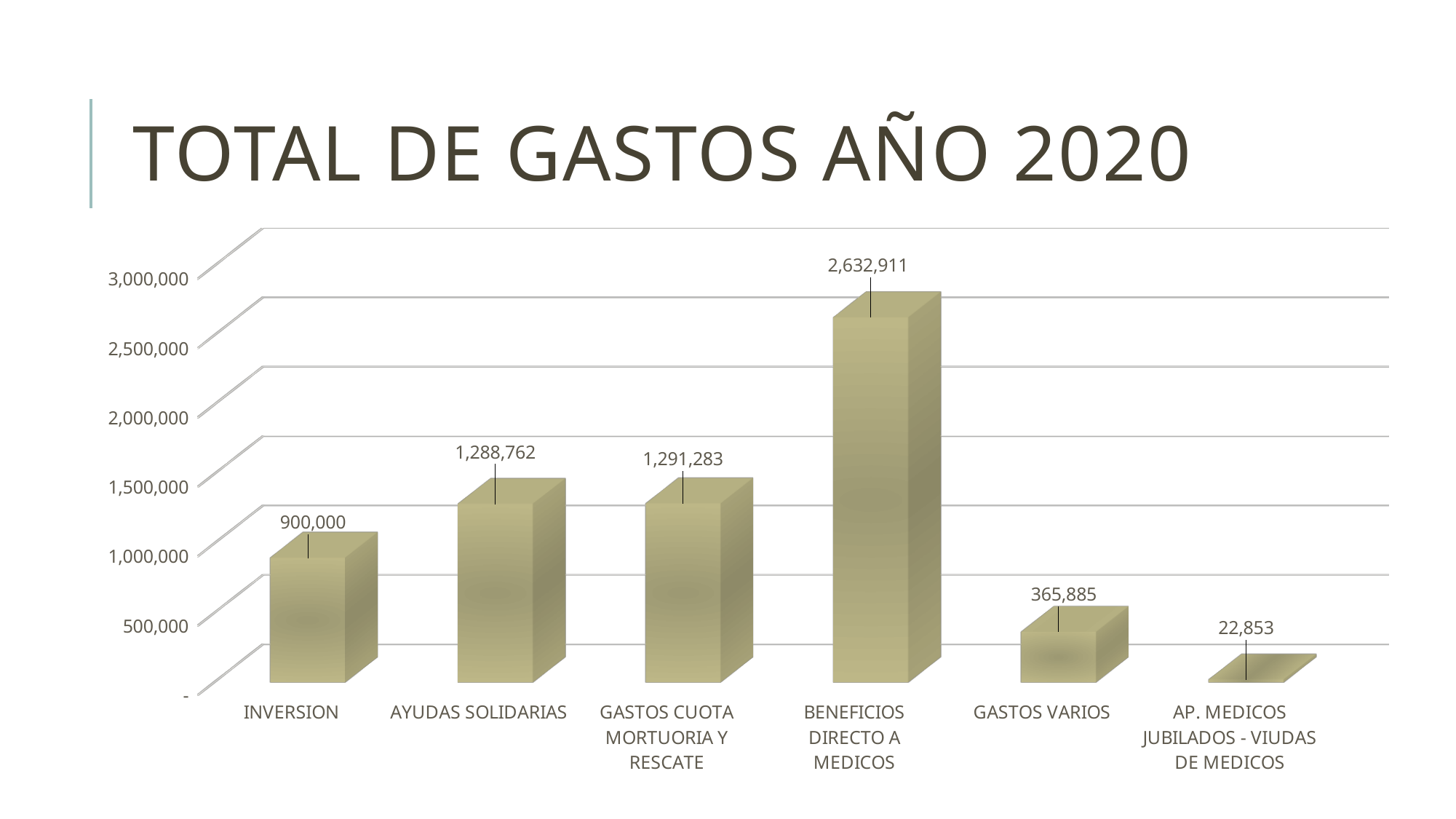
What is the difference between GASTOS CUOTA MORTUORIA Y RESCATE and AYUDAS SOLIDARIAS? 2,521 Is the value for INVERSION greater or less than 1,000,000? less What is the difference between BENEFICIOS DIRECTO A MEDICOS and INVERSION? 1,732,911 How many categories are shown in the chart? 6 Which category has the lowest value? AP. MEDICOS JUBILADOS - VIUDAS DE MEDICOS What is the value for AP. MEDICOS JUBILADOS - VIUDAS DE MEDICOS? 22,853 What is the value for INVERSION? 900,000 What is the value for BENEFICIOS DIRECTO A MEDICOS? 2,632,911 Which is larger, INVERSION or GASTOS VARIOS? INVERSION Which category has the highest value? BENEFICIOS DIRECTO A MEDICOS What is the value for GASTOS VARIOS? 365,885 What is the title of the chart? TOTAL DE GASTOS AÑO 2020